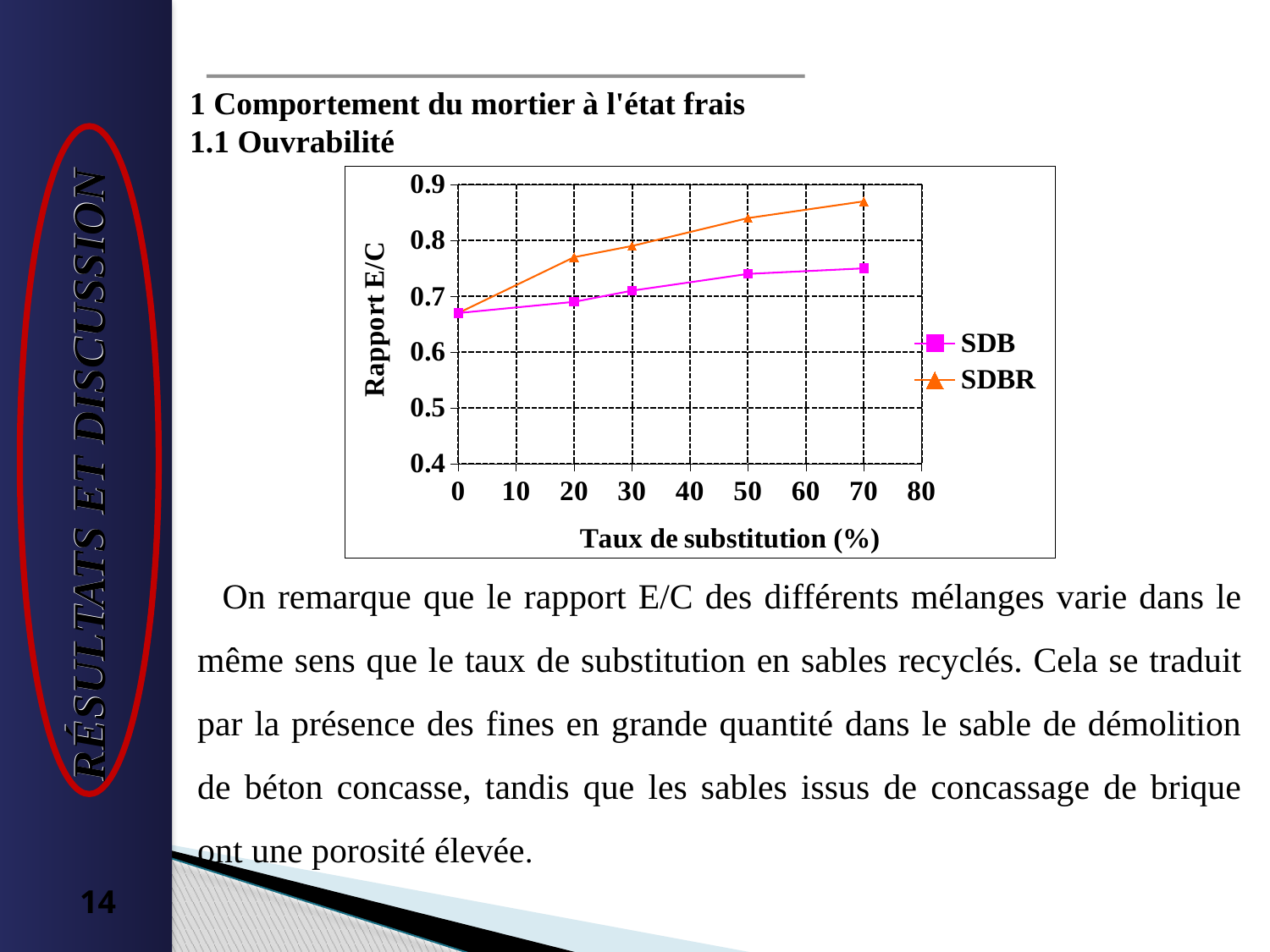
What kind of chart is shown on the slide? line chart What are the two series named in the legend? SDB and SDBR Is the Rapport E/C for SDB at 70% substitution greater or less than 0.8? less Does the Rapport E/C for SDB rise or fall as the Taux de substitution increases? rise How many series does the legend list? 2 Does the Rapport E/C for SDBR rise or fall as the Taux de substitution increases? rise Is the Rapport E/C for SDBR at 20% substitution greater or less than 0.7? greater At a Taux de substitution of 70%, which series has the higher Rapport E/C, SDB or SDBR? SDBR Is the Rapport E/C for SDB at 0% substitution greater or less than 0.7? less What is the title of the x axis? Taux de substitution (%) How many data points are plotted for the SDB series? 5